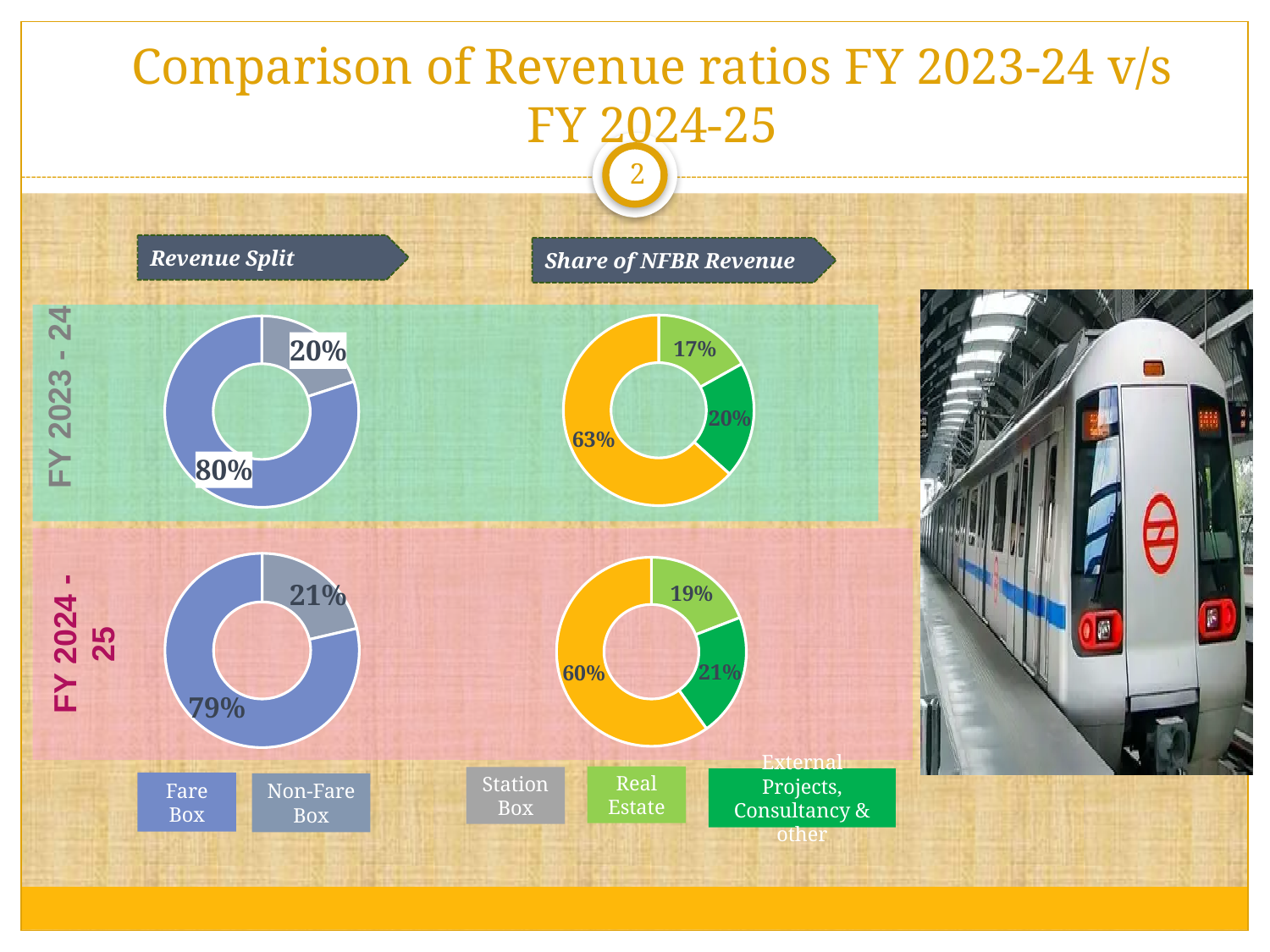
In the Revenue Split chart for FY 2024-25, what share is Non-Fare Box? 21% Is the Real Estate share of NFBR Revenue larger in FY 2023-24 or FY 2024-25? FY 2024-25 In the Share of NFBR Revenue chart for FY 2024-25, what share is External Projects, Consultancy & other? 21% How many charts are shown on the slide in total? 4 By how many percentage points did the Fare Box share in the Revenue Split chart change from FY 2023-24 to FY 2024-25? 1 percentage point (80% to 79%) What type of chart is used to show the Revenue Split for FY 2023-24? Donut (pie) chart In the Share of NFBR Revenue chart for FY 2024-25, which category has the largest share? Station Box In the Share of NFBR Revenue chart for FY 2023-24, which category has the smallest share? Real Estate In the Revenue Split chart for FY 2023-24, what share is Fare Box? 80% In the Share of NFBR Revenue chart for FY 2023-24, what share is Real Estate? 17% How many categories does the Share of NFBR Revenue chart for FY 2024-25 show? 3 In the Share of NFBR Revenue chart for FY 2023-24, what is the difference between the Station Box share and the External Projects, Consultancy & other share? 43 percentage points